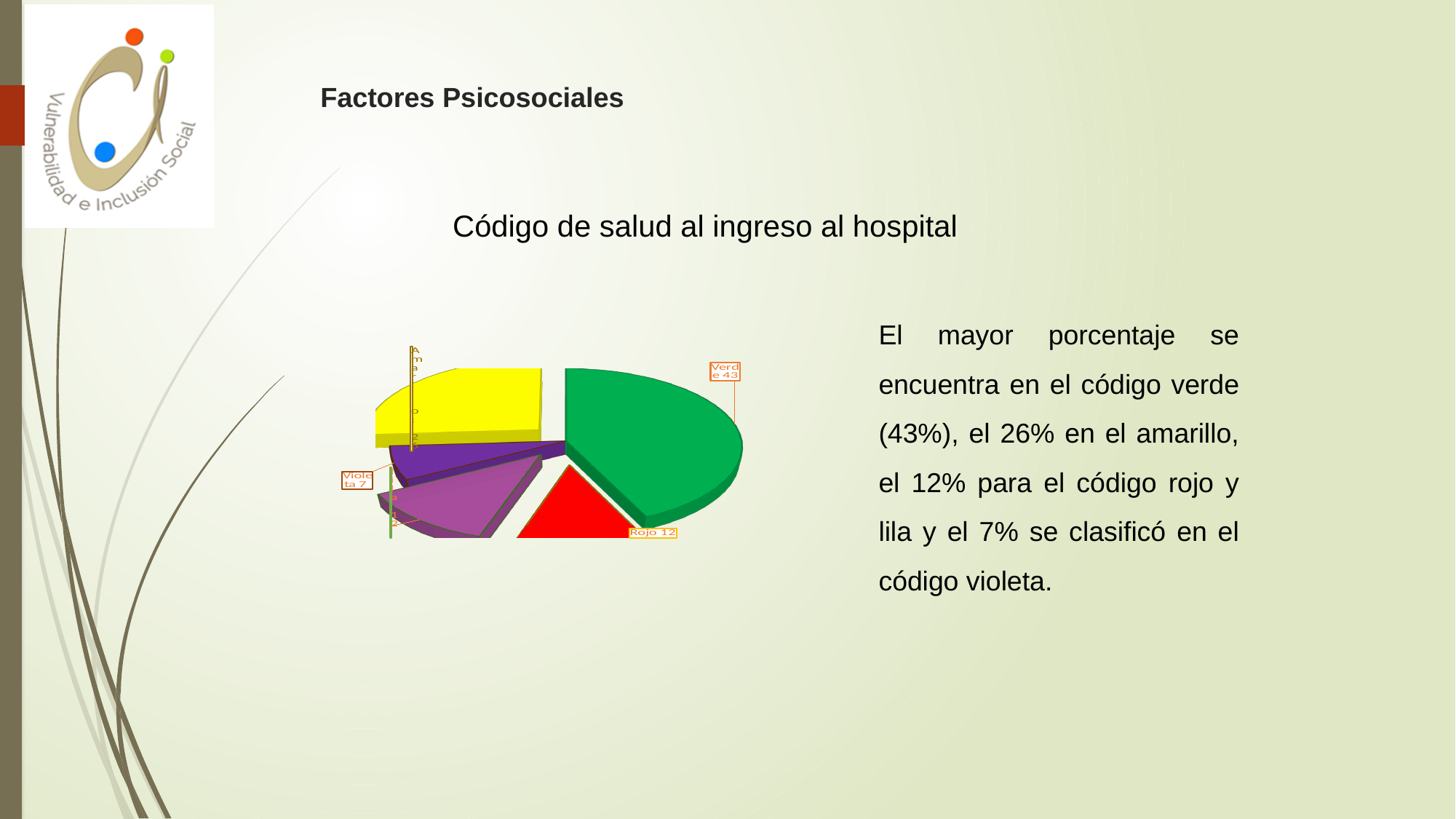
What is the title of the chart? Código de salud al ingreso al hospital What value is labelled for the Violeta slice? 7 What kind of chart is shown on the slide? pie chart Which slice of the pie is the smallest? Violeta How many slices does the pie chart have? 5 What colour is the largest slice of the pie? green What is the difference between the Verde value and the Rojo value? 31 Which slice of the pie is the largest? Verde What is the difference between the Rojo value and the Violeta value? 5 Which is larger, the Verde slice or the Rojo slice? Verde What value is labelled for the Rojo slice? 12 What value is labelled for the Verde slice? 43